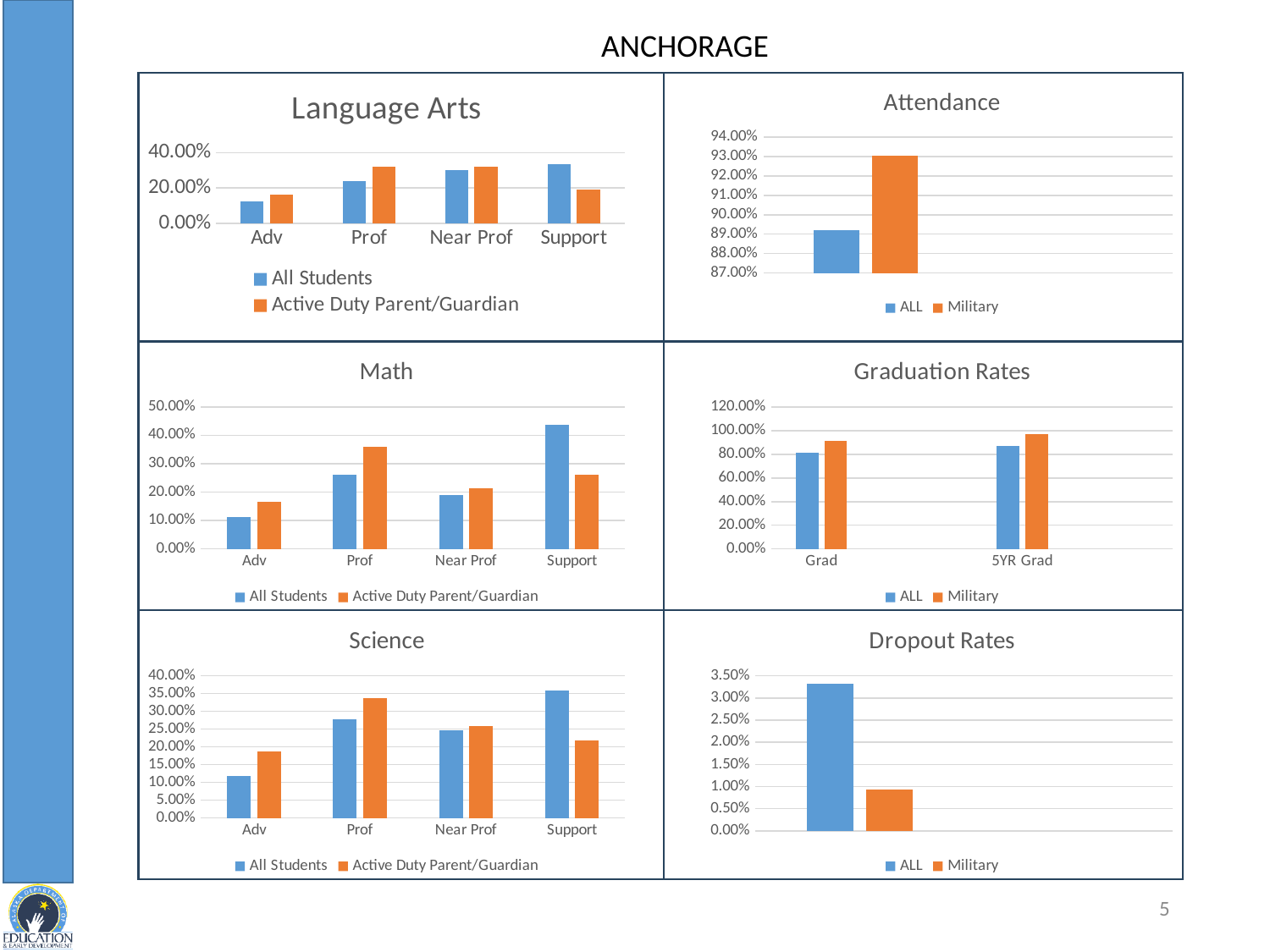
In the Science chart, which category has the lowest value for All Students? Adv In the Dropout Rates chart, is the value for ALL greater or less than 3.00%? greater In the Graduation Rates chart, how many categories are shown on the x axis? 2 In the Attendance chart, is the value for Military greater or less than 92.00%? greater What type of chart is the Dropout Rates chart? bar chart In the Math chart, which category has the highest value for Active Duty Parent/Guardian? Prof In the Science chart, is the value for Active Duty Parent/Guardian at Support greater or less than 20.00%? greater In the Attendance chart, which series has the higher value, ALL or Military? Military In the Dropout Rates chart, which series has the lower dropout rate, ALL or Military? Military In the Language Arts chart, how many series does the legend list? 2 In the Math chart, which category has the highest value for All Students? Support